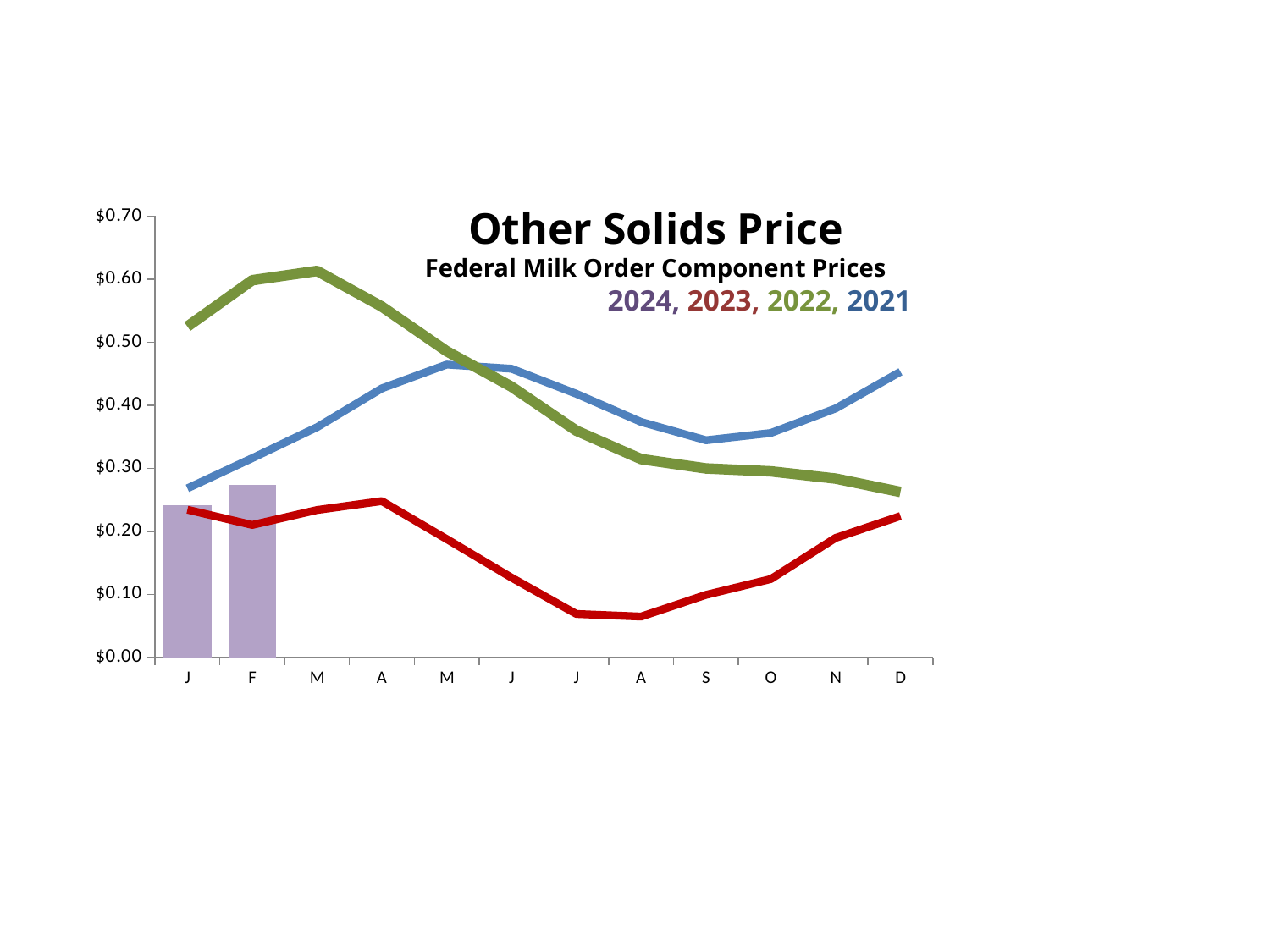
In February, which is higher: the 2024 bar or the 2023 line? 2024 How many months are shown along the x axis? 12 Is the 2021 value for December greater or less than $0.40? greater Is the 2023 value for August greater or less than $0.10? less In January, which is higher: the 2022 value or the 2021 value? 2022 What kind of chart is shown on the slide? A combination bar and line chart In which month does the 2022 line reach its highest value? M (March) Does the 2022 line rise or fall from March to December? fall Is the 2022 value for January greater or less than $0.50? greater How many years (series) does the chart's legend list? 4 What is the title of the chart? Other Solids Price